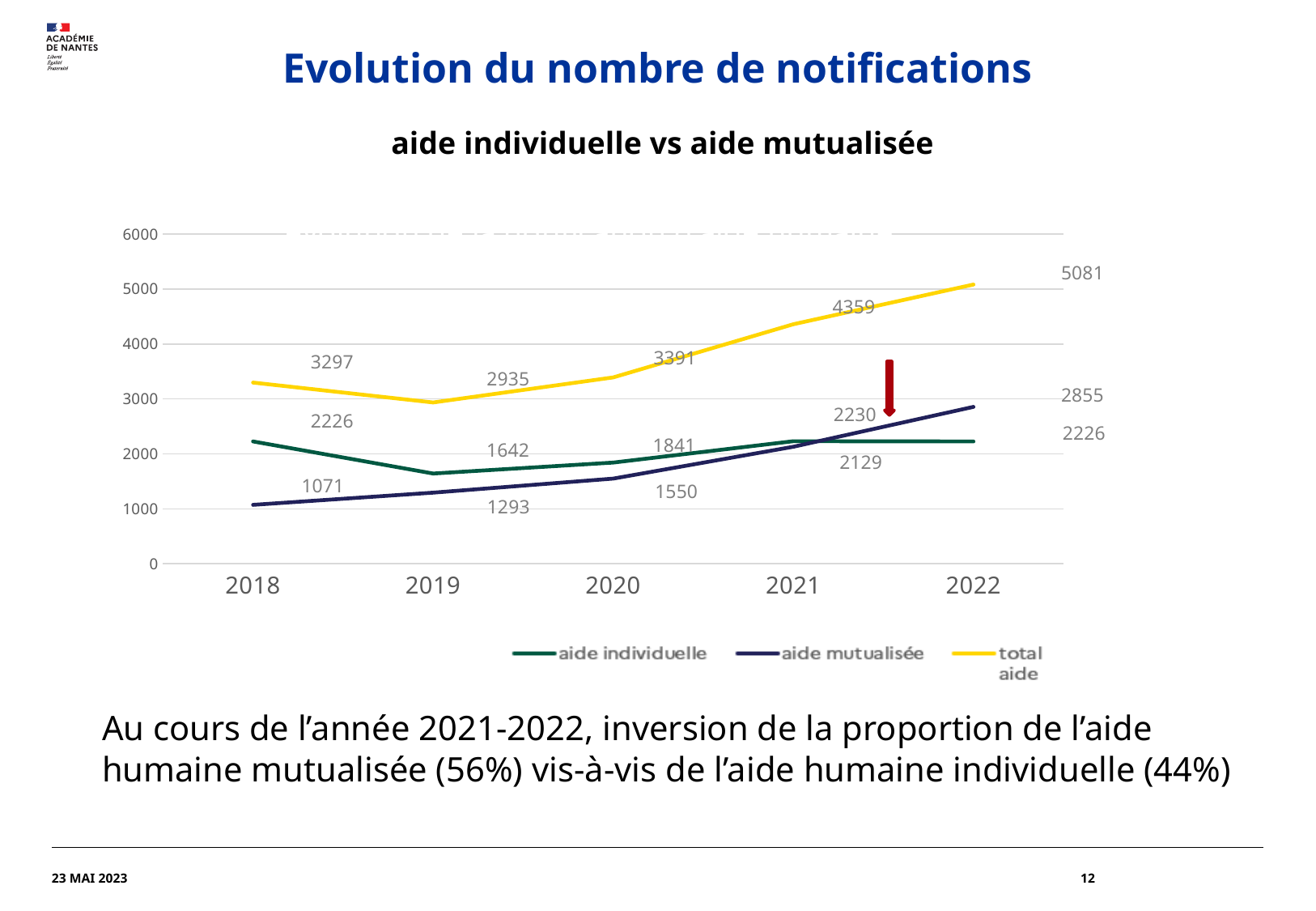
In which year is total aide lowest? 2019 What is the value of aide individuelle in 2019? 1642 Which is larger in 2020, aide individuelle or aide mutualisée? aide individuelle What is the difference between aide mutualisée and aide individuelle in 2022? 629 What is the value of total aide in 2022? 5081 What is the value of aide mutualisée in 2018? 1071 How many years are plotted along the x axis? 5 What type of chart is shown on the slide? line chart How many series does the legend list? 3 Does aide mutualisée rise or fall from 2018 to 2022? rise In which year is aide mutualisée highest? 2022 What colour is the line for total aide? yellow